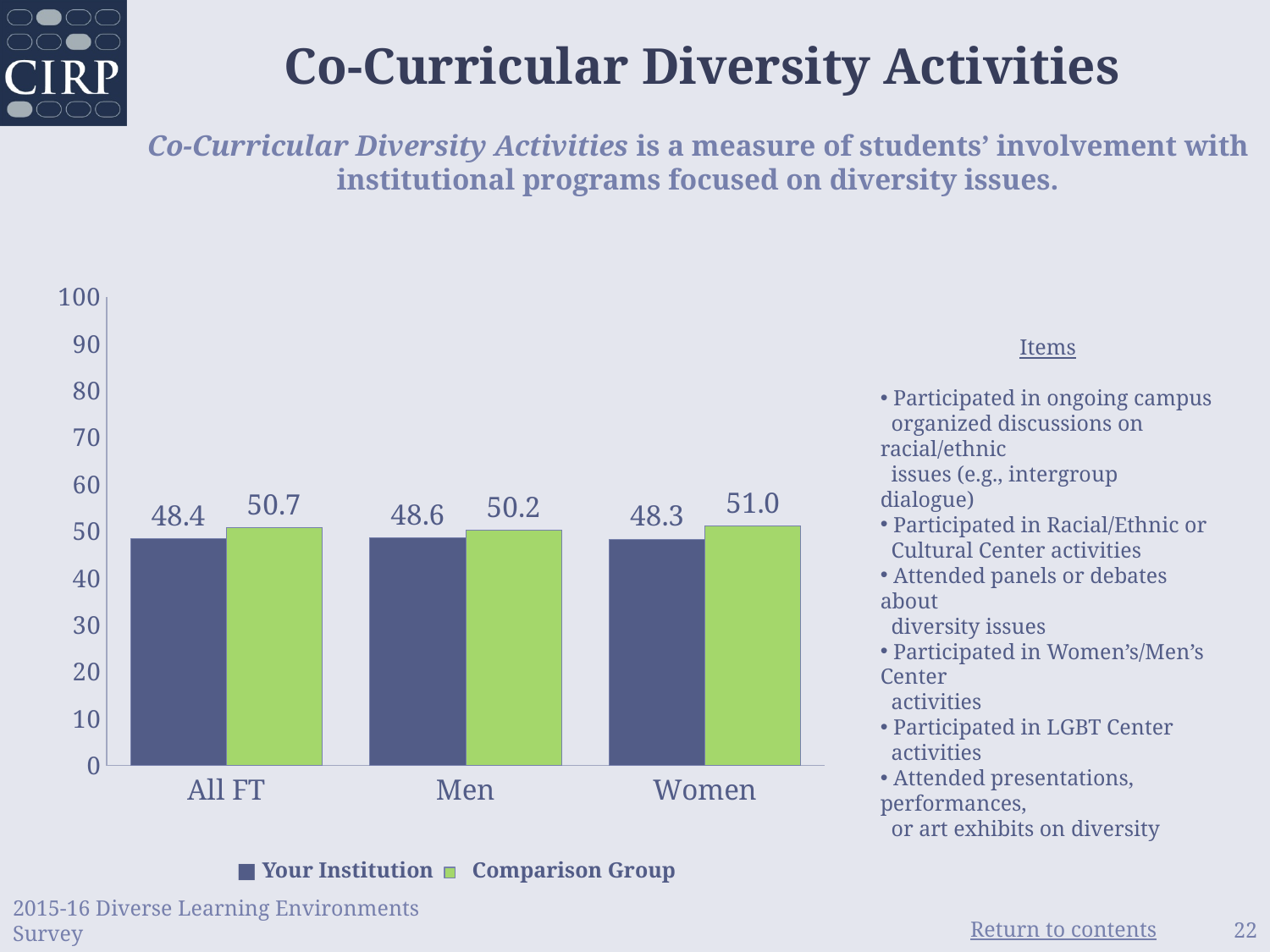
What is the value for Comparison Group in the Men category? 50.2 What kind of chart is shown on the slide? Bar chart What is the difference between the Comparison Group and Your Institution values for Women? 2.7 What is the value for Your Institution in the All FT category? 48.4 Which category has the lowest Your Institution value? Women How many series does the legend list? 2 What is the maximum value shown on the y axis? 100 How many categories are shown on the x axis? 3 What is the value for Your Institution in the Men category? 48.6 For All FT, which is larger: Your Institution or Comparison Group? Comparison Group What is the value for Comparison Group in the Women category? 51.0 Which category has the highest Comparison Group value? Women